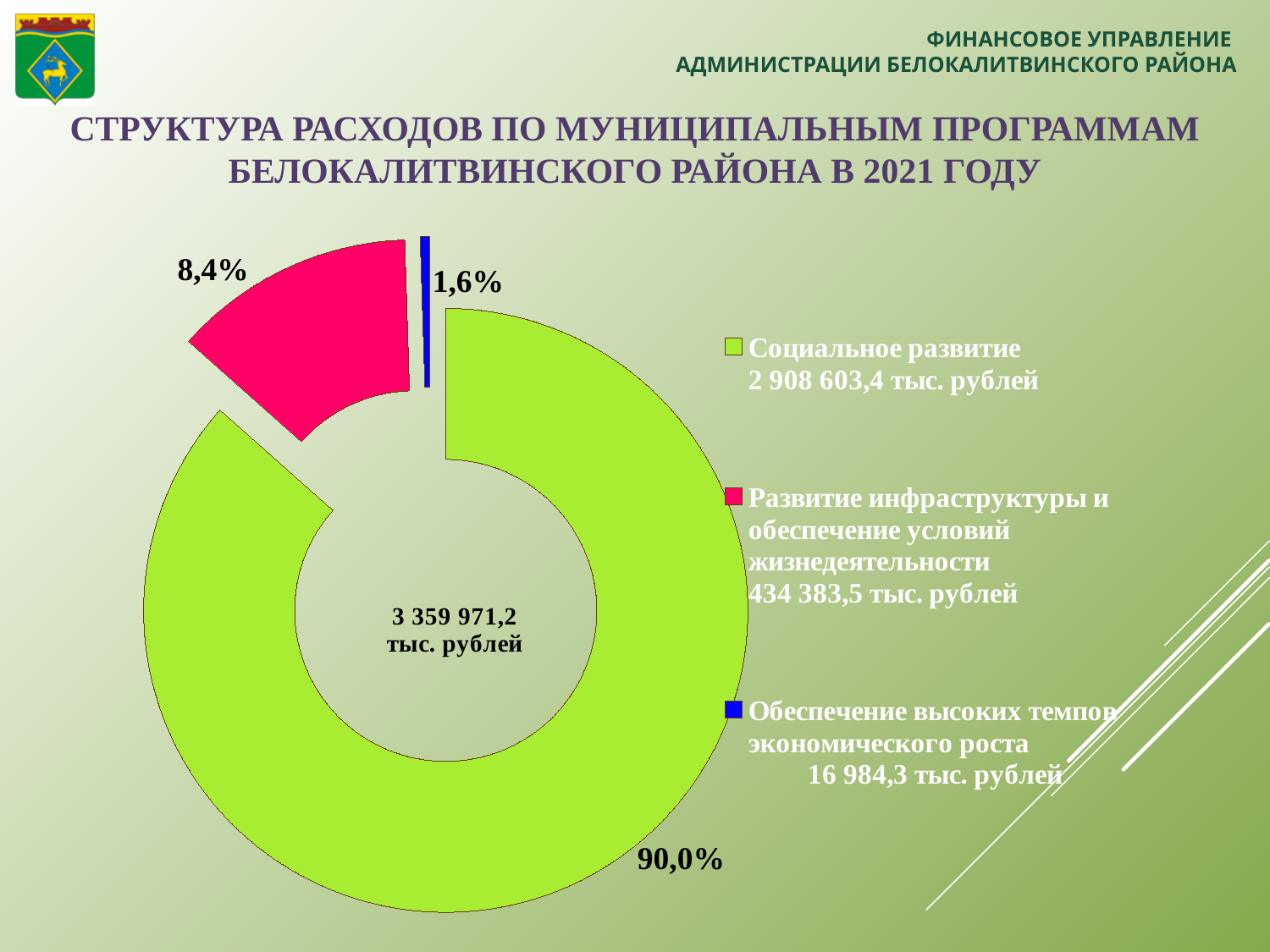
Какая программа имеет наибольшую долю расходов? Социальное развитие Какова сумма расходов по программе «Социальное развитие»? 2 908 603,4 тыс. рублей Какова сумма расходов по программе «Обеспечение высоких темпов экономического роста»? 16 984,3 тыс. рублей Какую долю расходов занимает «Социальное развитие»? 90,0% Какая программа имеет наименьшую долю расходов? Обеспечение высоких темпов экономического роста Сколько категорий (секторов) показано на диаграмме? 3 Какую долю расходов занимает «Развитие инфраструктуры и обеспечение условий жизнедеятельности»? 8,4% Какую долю расходов занимает «Обеспечение высоких темпов экономического роста»? 1,6% Какова сумма расходов по программе «Развитие инфраструктуры и обеспечение условий жизнедеятельности»? 434 383,5 тыс. рублей Какой тип диаграммы показан на слайде? кольцевая (круговая) диаграмма Какая общая сумма расходов указана в центре диаграммы? 3 359 971,2 тыс. рублей На сколько процентных пунктов доля «Развитие инфраструктуры и обеспечение условий жизнедеятельности» больше доли «Обеспечение высоких темпов экономического роста»? 6,8